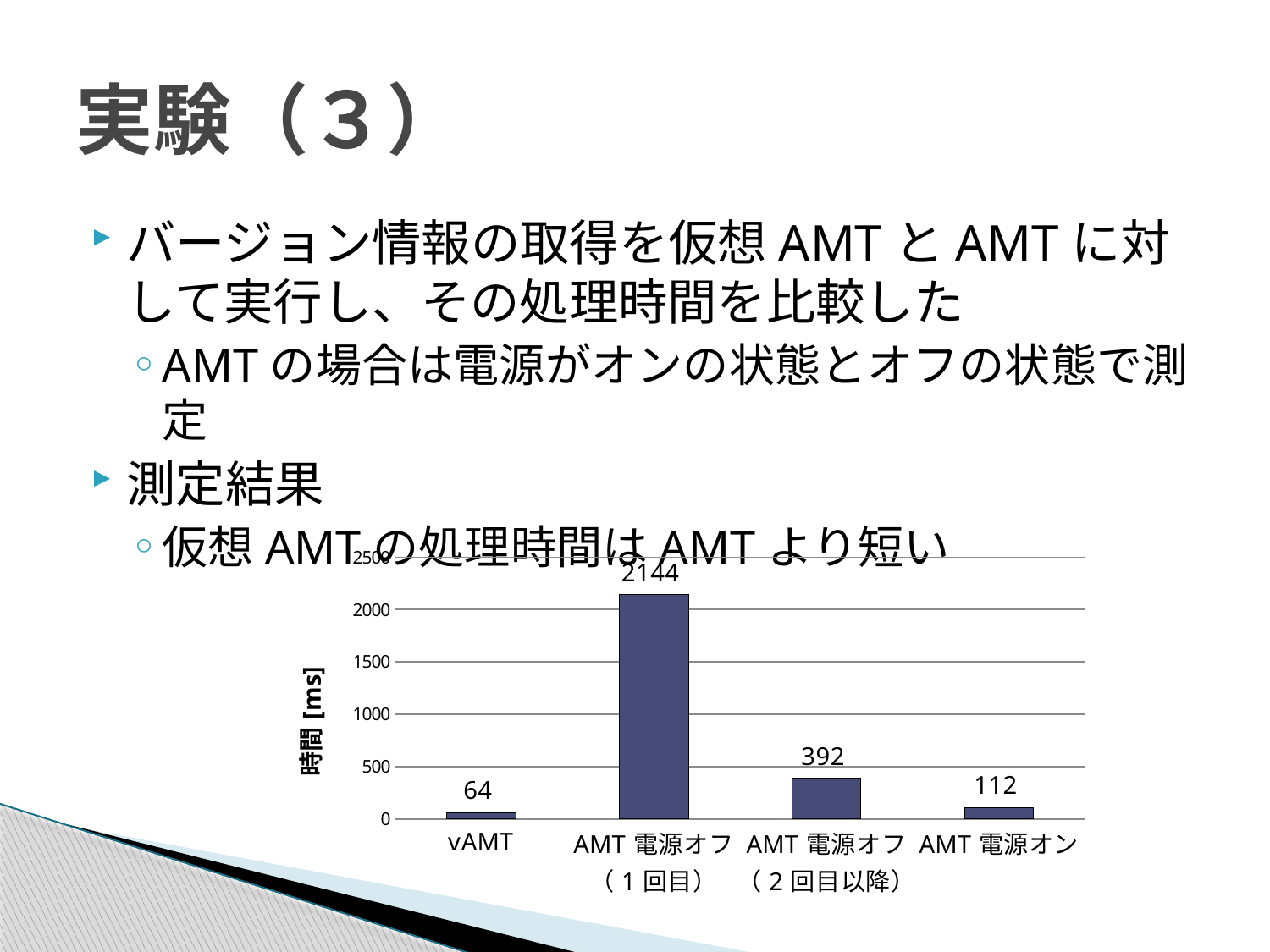
What kind of chart is shown on the slide? bar chart Which category has the lowest value? vAMT What is the label of the vertical axis? 時間 [ms] What is the value for AMT 電源オフ（1回目）? 2144 Which category has the highest value? AMT 電源オフ（1回目） What is the difference between AMT 電源オン and vAMT? 48 How many categories are shown in the chart? 4 Which is larger, the value for AMT 電源オフ（2回目以降） or AMT 電源オン? AMT 電源オフ（2回目以降） What is the value for AMT 電源オン? 112 What is the difference between AMT 電源オフ（1回目） and AMT 電源オフ（2回目以降）? 1752 What is the value for AMT 電源オフ（2回目以降）? 392 What is the value for vAMT? 64